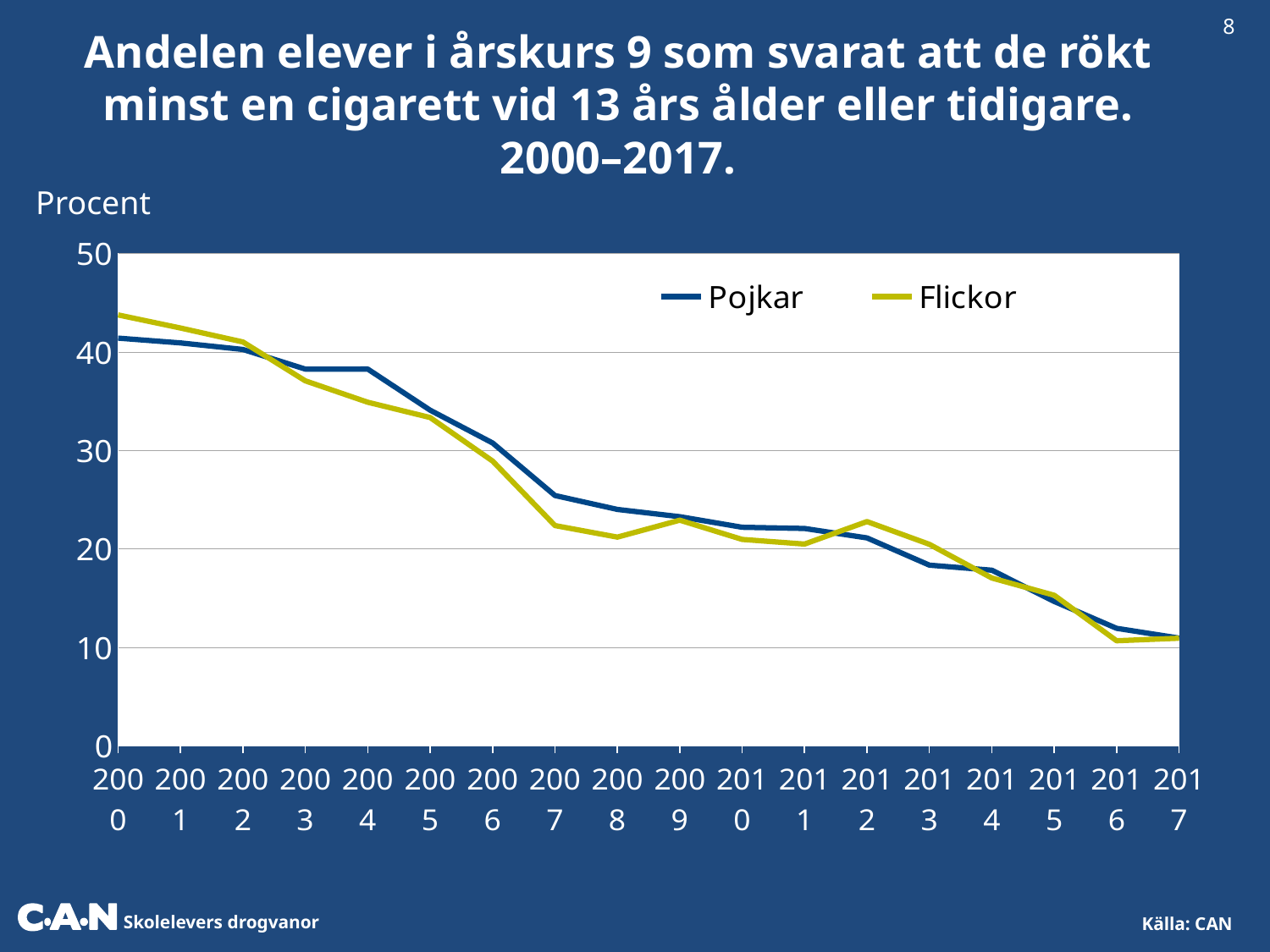
Is the value for Flickor in 2016 greater or less than 20? less In which year is the value for Flickor highest? 2000 Is the value for Flickor in 2000 greater or less than 40? greater How many series does the legend list? 2 In 2000, which series has the higher value, Pojkar or Flickor? Flickor What kind of chart is shown on the slide? line chart Is the value for Pojkar in 2007 greater or less than 30? less How many years are plotted along the x axis? 18 Do the values for Pojkar rise or fall overall from 2000 to 2017? fall What colour is the line for Pojkar? blue What label is shown above the y axis? Procent In 2004, which series has the higher value, Pojkar or Flickor? Pojkar